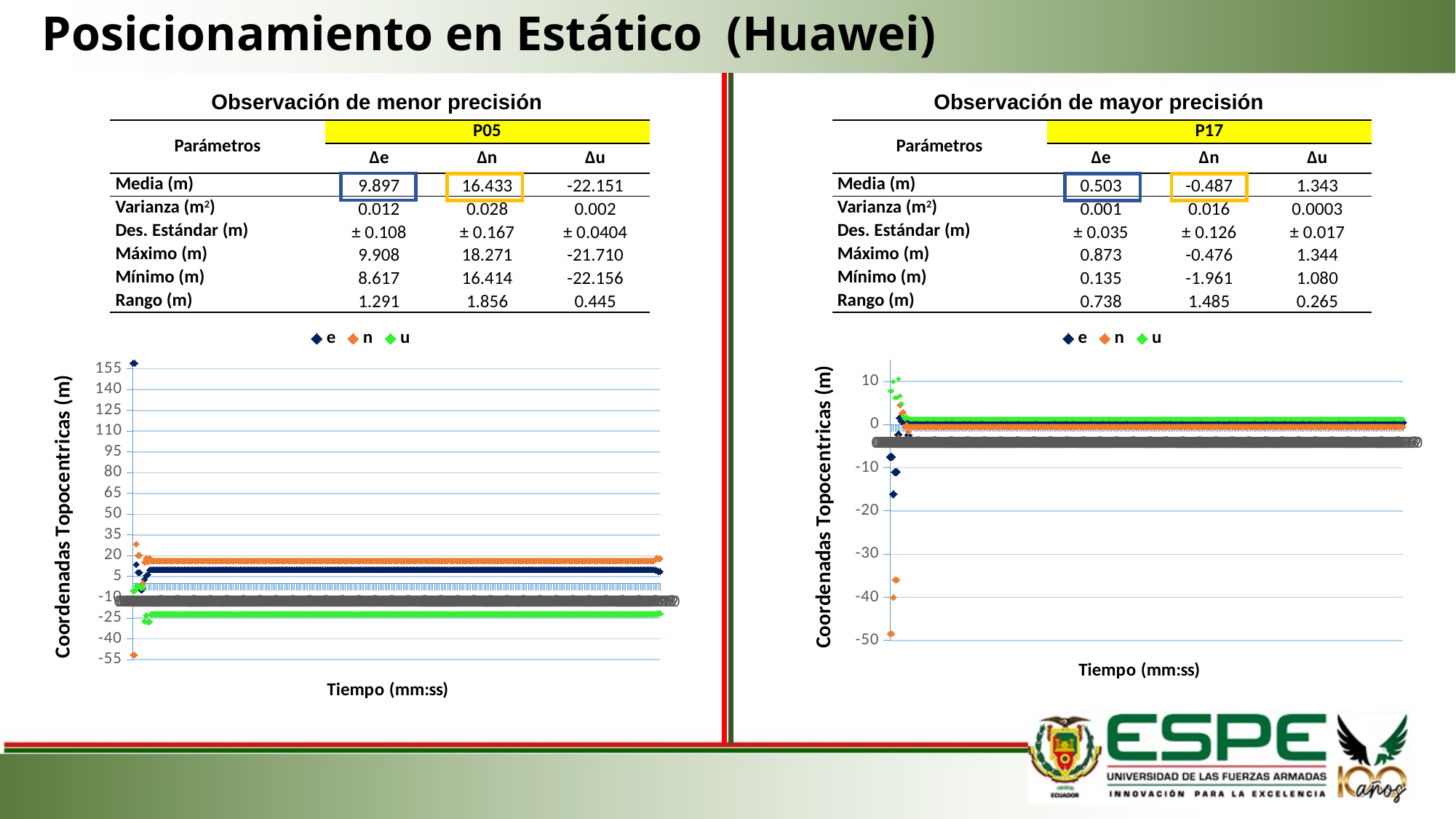
In the right chart (Observación de mayor precisión), do the plotted values of the green u series rise or fall over the first few time steps before levelling off? fall In the left chart (Observación de menor precisión), is the steady value of the orange n series greater or less than 5? greater How many series does the legend of the left chart (Observación de menor precisión) list? 3 In the right chart (Observación de mayor precisión), is the lowest plotted orange n point greater or less than -40? less In the left chart (Observación de menor precisión), which series settles at the lowest steady value: e, n or u? u In the right chart (Observación de mayor precisión), is the lowest plotted blue e point greater or less than -10? less What is the y-axis title of the left chart? Coordenadas Topocentricas (m) What kind of chart is shown on the left side of the slide, under the P05 table? scatter chart In the left chart (Observación de menor precisión), which series settles at the highest steady value: e, n or u? n What are the legend entries of the right chart (Observación de mayor precisión)? e, n, u